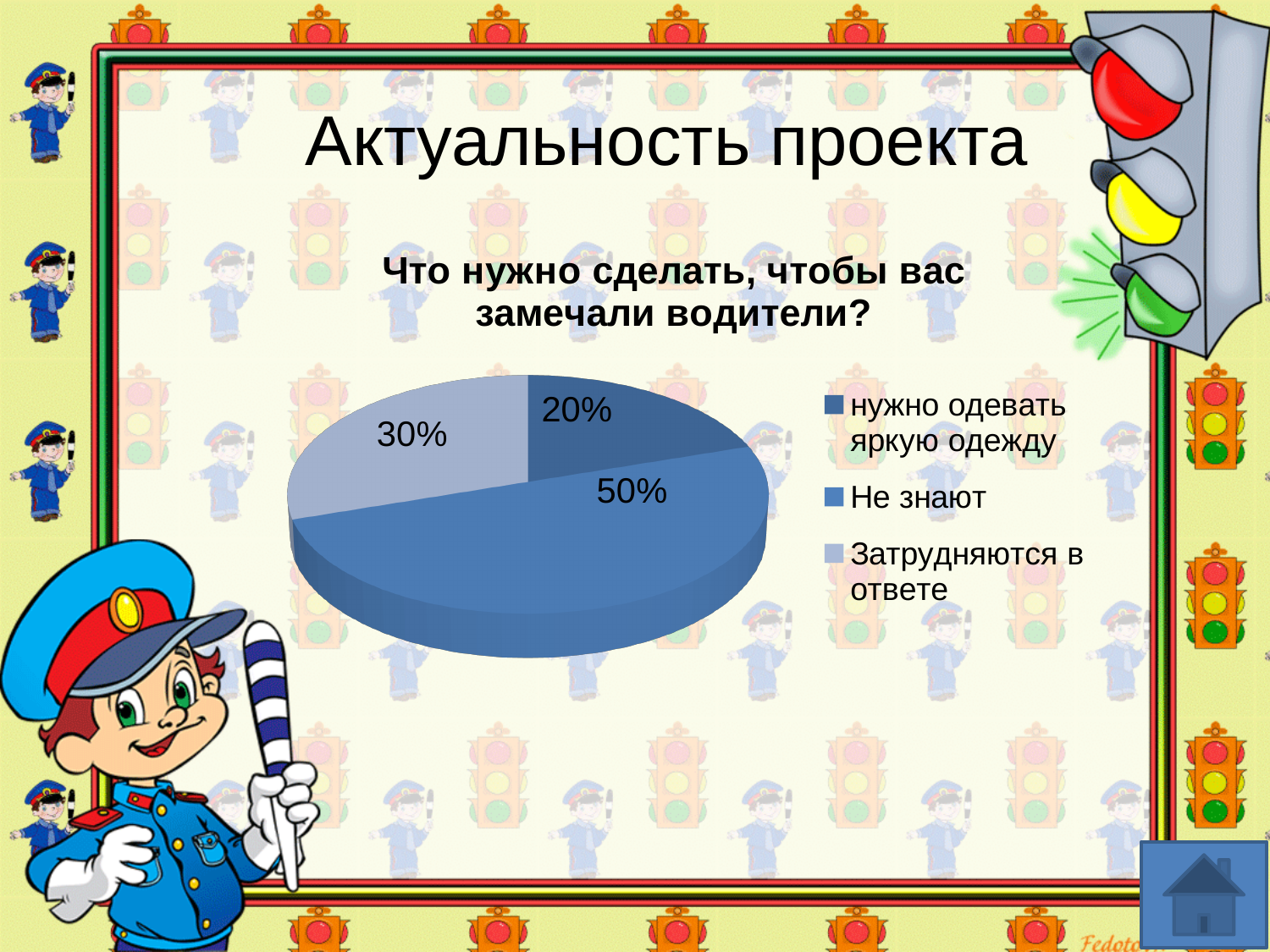
What share of the pie does "Затрудняются в ответе" have? 30% How many entries does the legend list? 3 Which category has the largest slice of the pie? Не знают Which is larger: the share for "Затрудняются в ответе" or the share for "нужно одевать яркую одежду"? Затрудняются в ответе What kind of chart is shown on the slide? pie chart How many slices does the pie chart have? 3 Which category has the smallest slice of the pie? нужно одевать яркую одежду What is the difference between the shares for "Затрудняются в ответе" and "нужно одевать яркую одежду"? 10% What share of the pie does "нужно одевать яркую одежду" have? 20% What is the difference between the shares for "Не знают" and "Затрудняются в ответе"? 20% What is the title of the chart? Что нужно сделать, чтобы вас замечали водители? What share of the pie does "Не знают" have? 50%